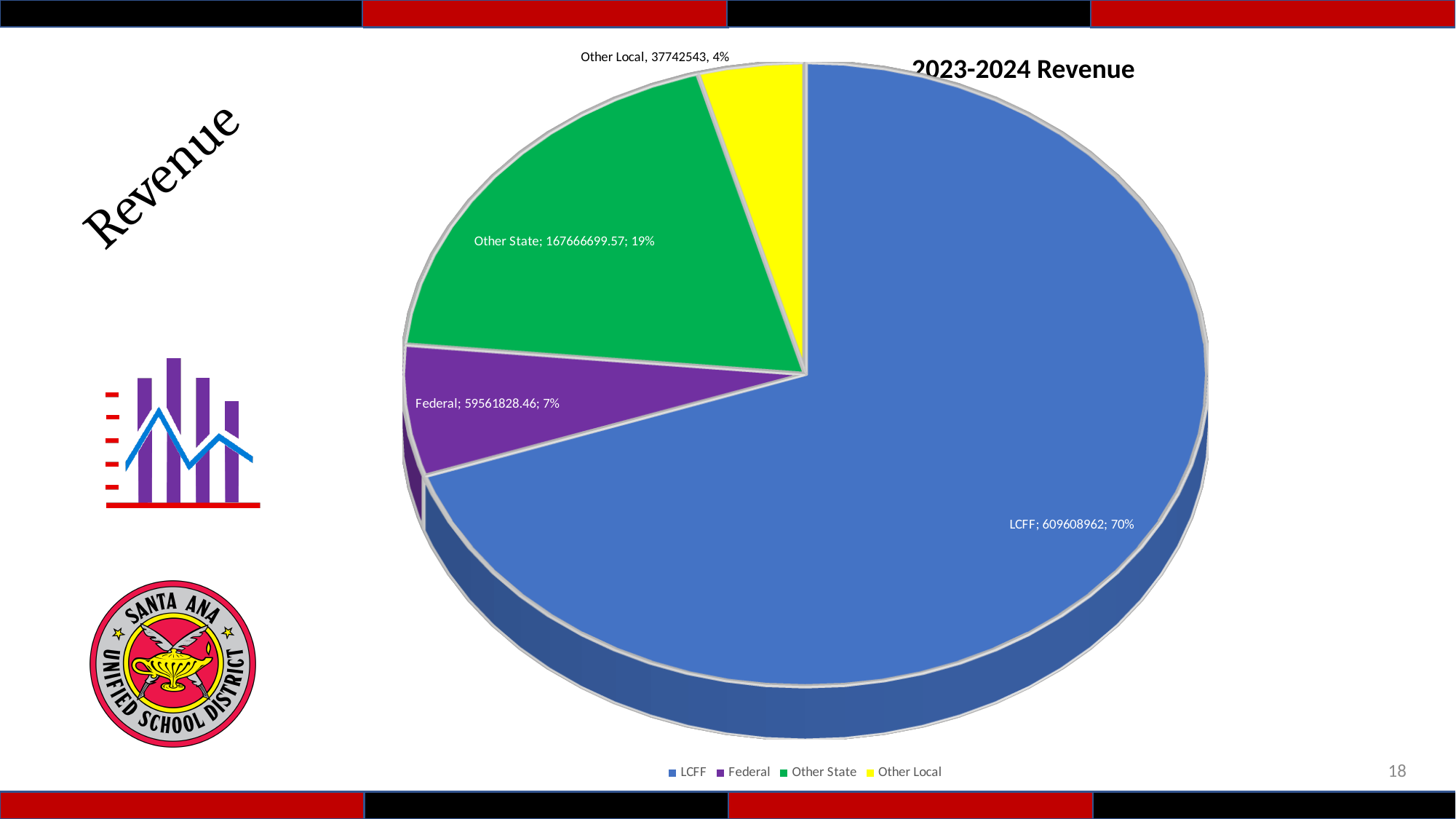
How many entries does the legend list? 4 What is the value shown for Other State? 167666699.57 What share of the pie does Other Local represent? 4% How many slices does the pie chart have? 4 Which is larger, Other State or Federal? Other State Which category has the largest slice? LCFF What is the value shown for LCFF? 609608962 Which category has the smallest slice? Other Local What is the value shown for Federal? 59561828.46 What share of the pie does LCFF represent? 70% What type of chart is shown on the slide? pie chart What is the title of the chart? 2023-2024 Revenue